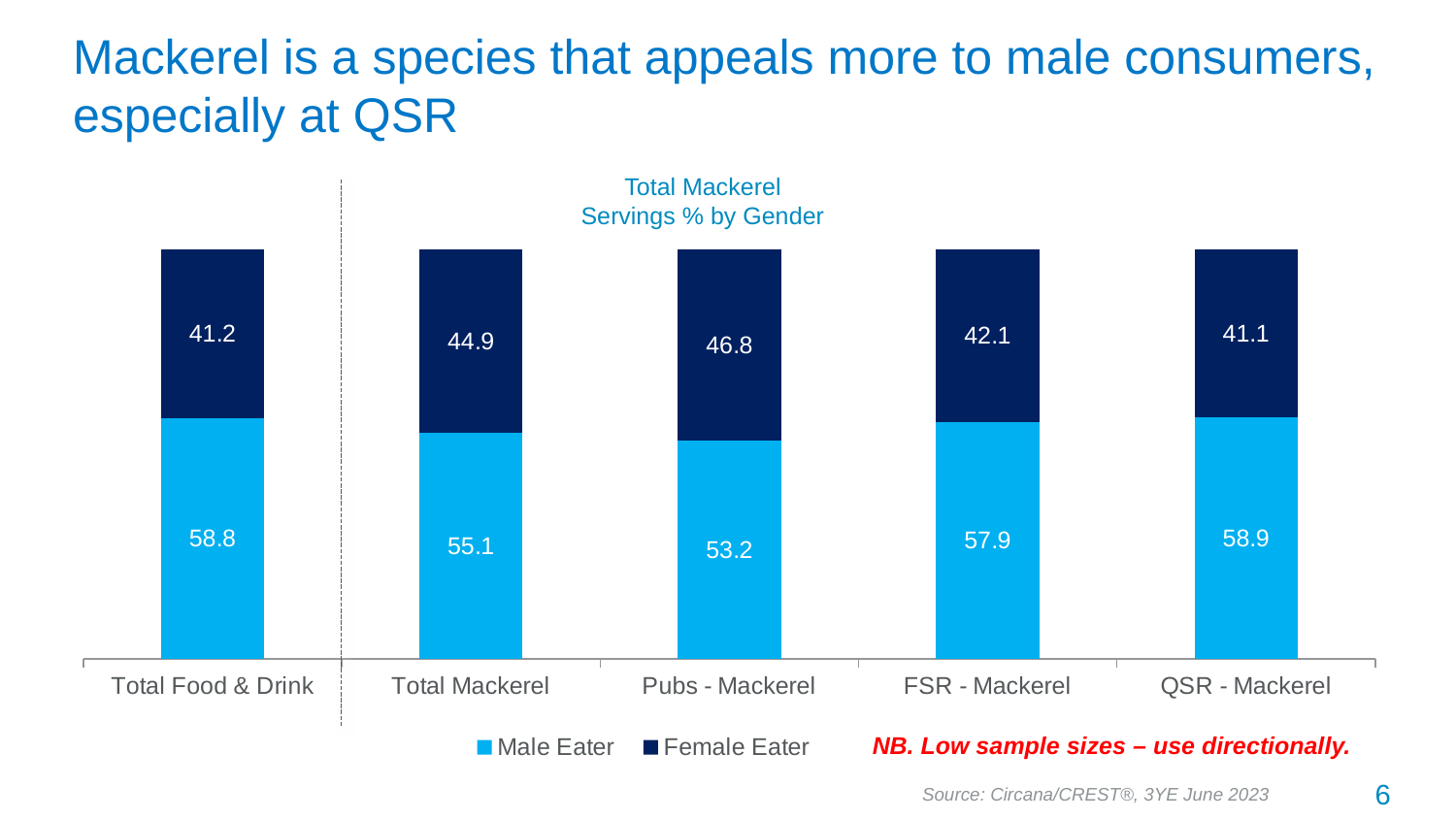
What kind of chart is shown on the slide? Stacked bar chart How many categories are shown on the x axis? 5 What is the Male Eater value for Total Food & Drink? 58.8 How many series does the legend list? 2 Which category has the highest Female Eater value? Pubs - Mackerel What is the Male Eater value for QSR - Mackerel? 58.9 What is the Female Eater value for Pubs - Mackerel? 46.8 What is the title of the chart? Total Mackerel Servings % by Gender Which is larger, the Female Eater value for FSR - Mackerel or for QSR - Mackerel? FSR - Mackerel What is the total of the stacked bar for FSR - Mackerel? 100 What is the difference between the Male Eater and Female Eater values for Total Mackerel? 10.2 Which category has the lowest Male Eater value? Pubs - Mackerel